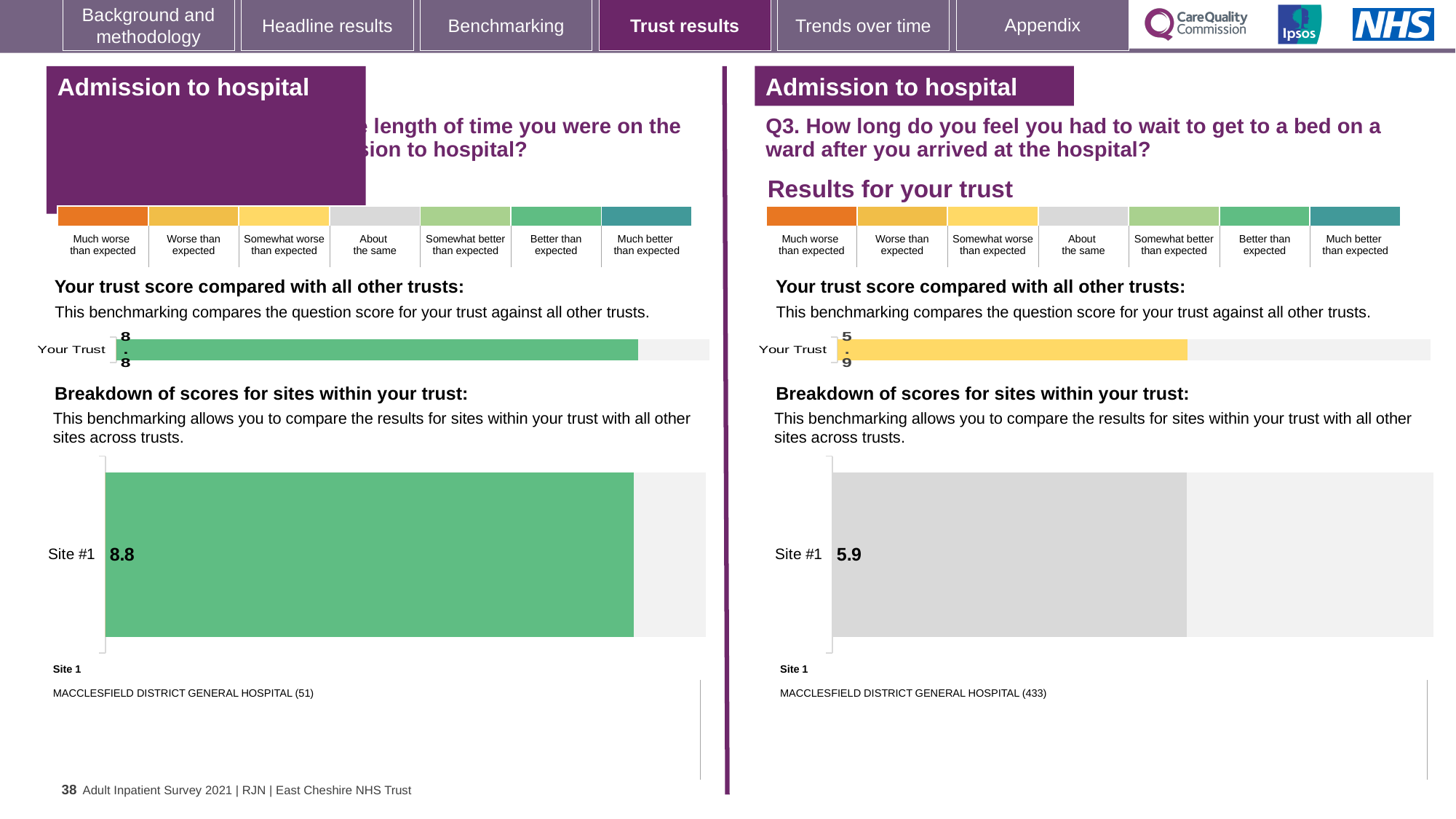
How many sites are shown in the left-hand 'Breakdown of scores for sites within your trust' chart? 1 What kind of chart is used to show the Your Trust score on the right-hand side of the slide? bar chart What is the difference between the Your Trust score on the left-hand chart (8.8) and the Your Trust score on the right-hand Q3 chart (5.9)? 2.9 How many rating categories does the colour legend above the right-hand Q3 charts list? 7 According to the colour legend, which rating category does the green colour of the left-hand Your Trust bar correspond to? Better than expected Is the Your Trust score larger on the left-hand chart or on the right-hand (Q3) chart? left-hand chart On the right-hand 'Breakdown of scores for sites within your trust' chart (Q3), what is the score for Site #1? 5.9 According to the colour legend, which rating category does the yellow colour of the right-hand Q3 Your Trust bar correspond to? Somewhat worse than expected On the left-hand 'Your trust score compared with all other trusts' chart, what is the score for Your Trust? 8.8 How many sites are shown in the right-hand 'Breakdown of scores for sites within your trust' chart? 1 On the left-hand 'Breakdown of scores for sites within your trust' chart, what is the score for Site #1? 8.8 On the right-hand 'Your trust score compared with all other trusts' chart (Q3), what is the score for Your Trust? 5.9